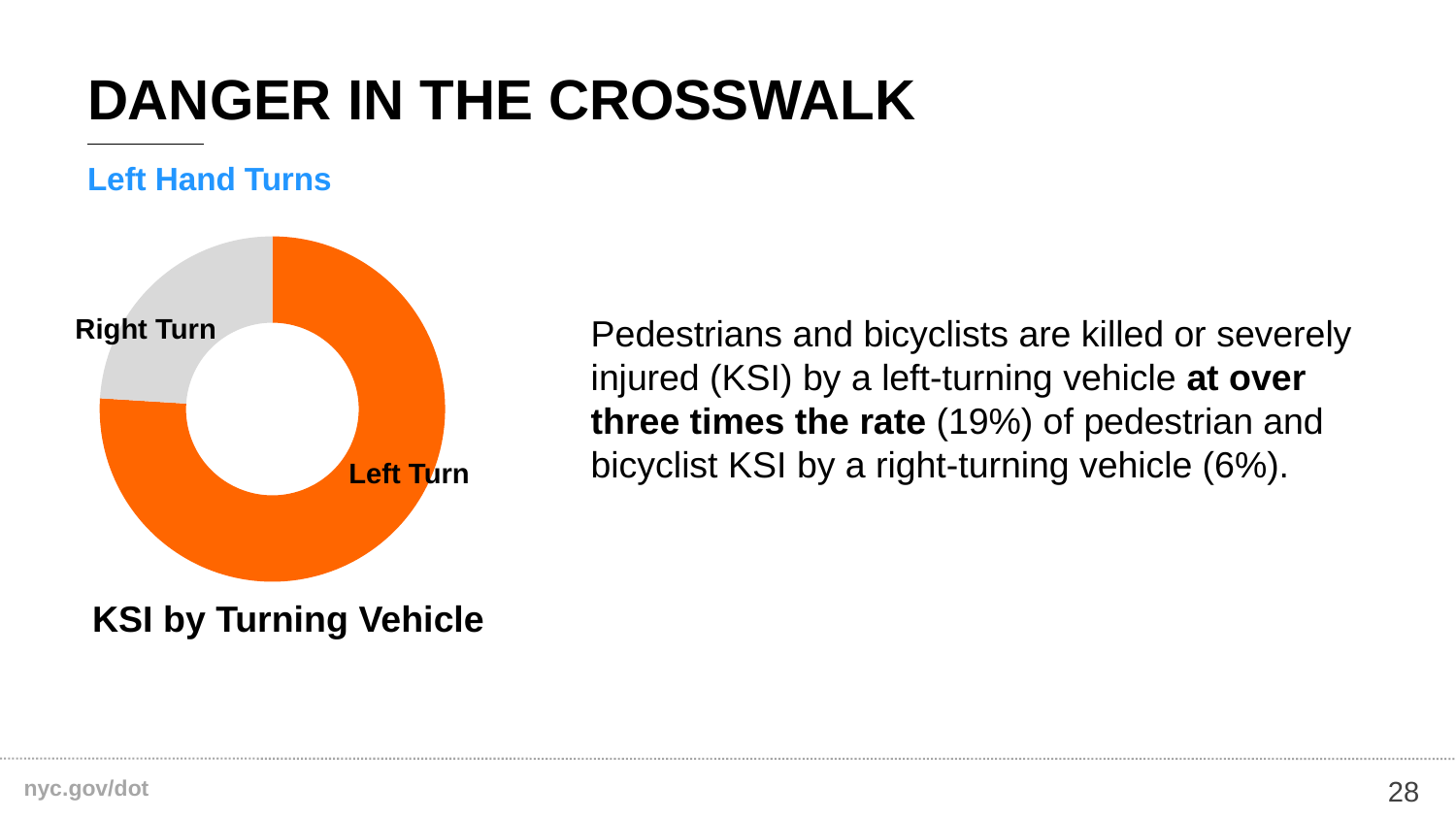
Does the Left Turn slice take up more or less than half of the chart? More How many categories does the KSI by Turning Vehicle chart show? 2 What is the title of the chart on the slide? KSI by Turning Vehicle What colour is the Left Turn slice in the chart? Orange Which category has the largest share in the KSI by Turning Vehicle chart? Left Turn Which is larger in the KSI by Turning Vehicle chart, Left Turn or Right Turn? Left Turn What kind of chart is shown on the slide? Pie chart (donut) Which category has the smallest share in the KSI by Turning Vehicle chart? Right Turn